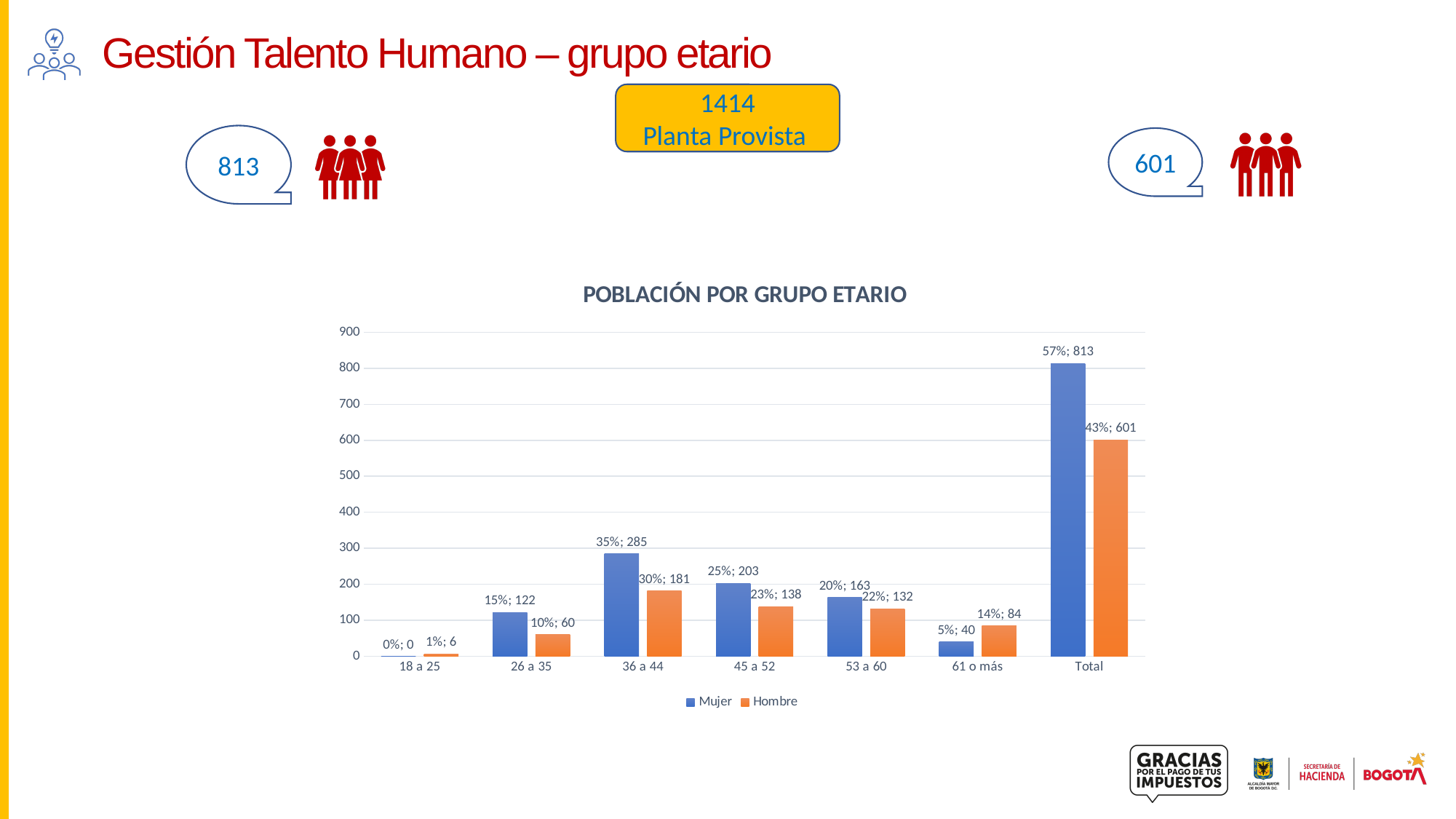
Excluding the Total category, which age group has the highest Mujer value? 36 a 44 What is the chart's title? POBLACIÓN POR GRUPO ETARIO Is the Mujer value for the 53 a 60 group greater or less than 200? less In the 61 o más group, which is larger, Mujer or Hombre? Hombre How many series does the legend list? 2 What type of chart is shown on the slide? bar chart What is the difference between the Mujer and Hombre values in the Total category? 212 What is the Hombre value for the 45 a 52 group? 138 What is the Mujer value for the 36 a 44 group? 285 How many categories are shown on the x axis? 7 Excluding the Total category, which age group has the lowest Hombre value? 18 a 25 What data label is shown for Hombre in the 61 o más group? 14%; 84